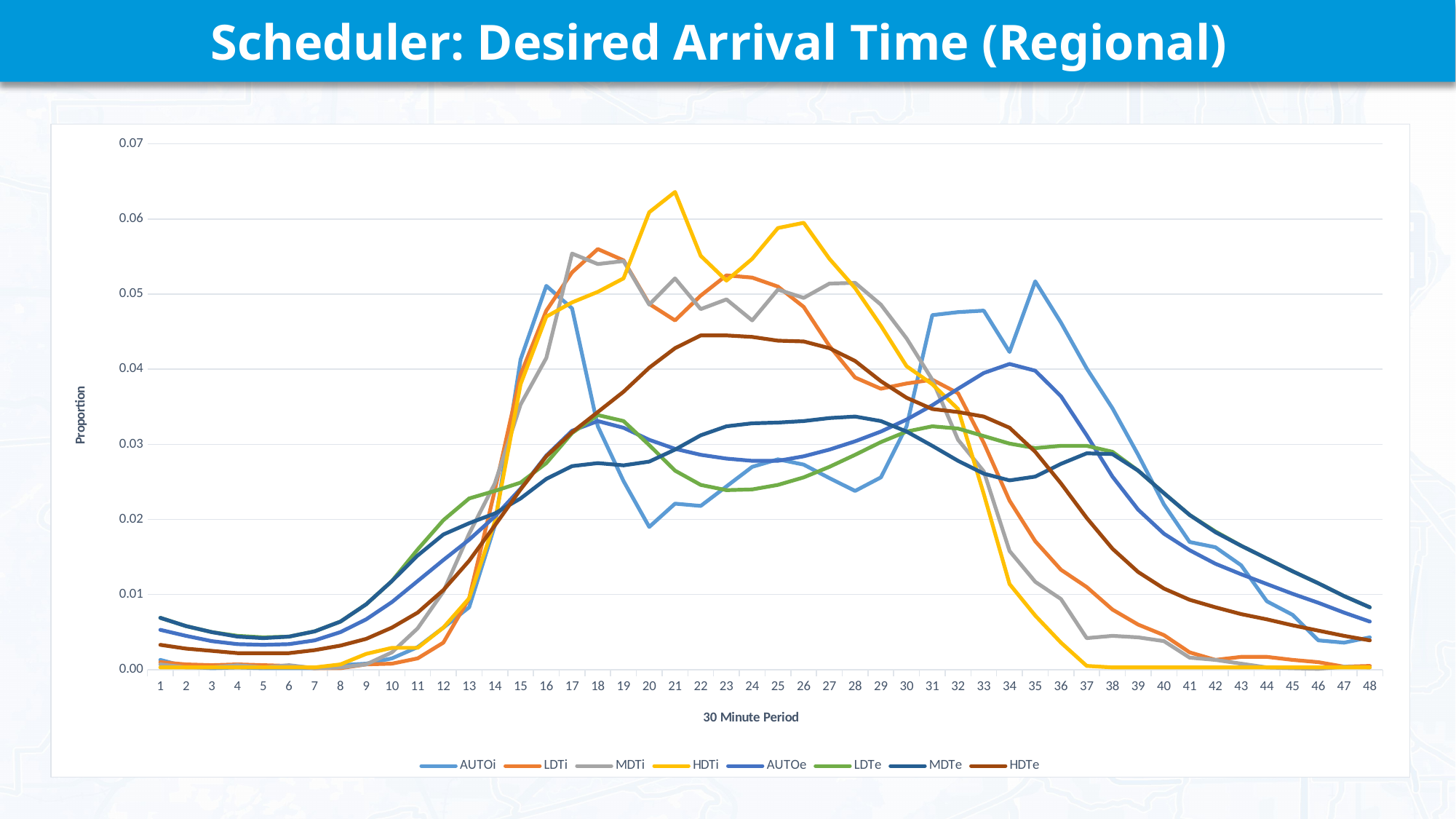
At period 21, which series has the larger value, HDTi or LDTi? HDTi How many series does the legend list? 8 What is the label of the y axis? Proportion Which series reaches the highest proportion anywhere on the chart? HDTi Is the value for HDTe at period 22 greater or less than 0.04? greater At period 40, which series has the larger value, MDTe or HDTi? MDTe What kind of chart is shown on the slide? line chart Is the value for HDTi at period 21 greater or less than 0.06? greater How many 30 minute periods are shown along the x axis? 48 Is the value for HDTi at period 37 greater or less than 0.01? less Does the HDTi line rise or fall between period 34 and period 37? fall